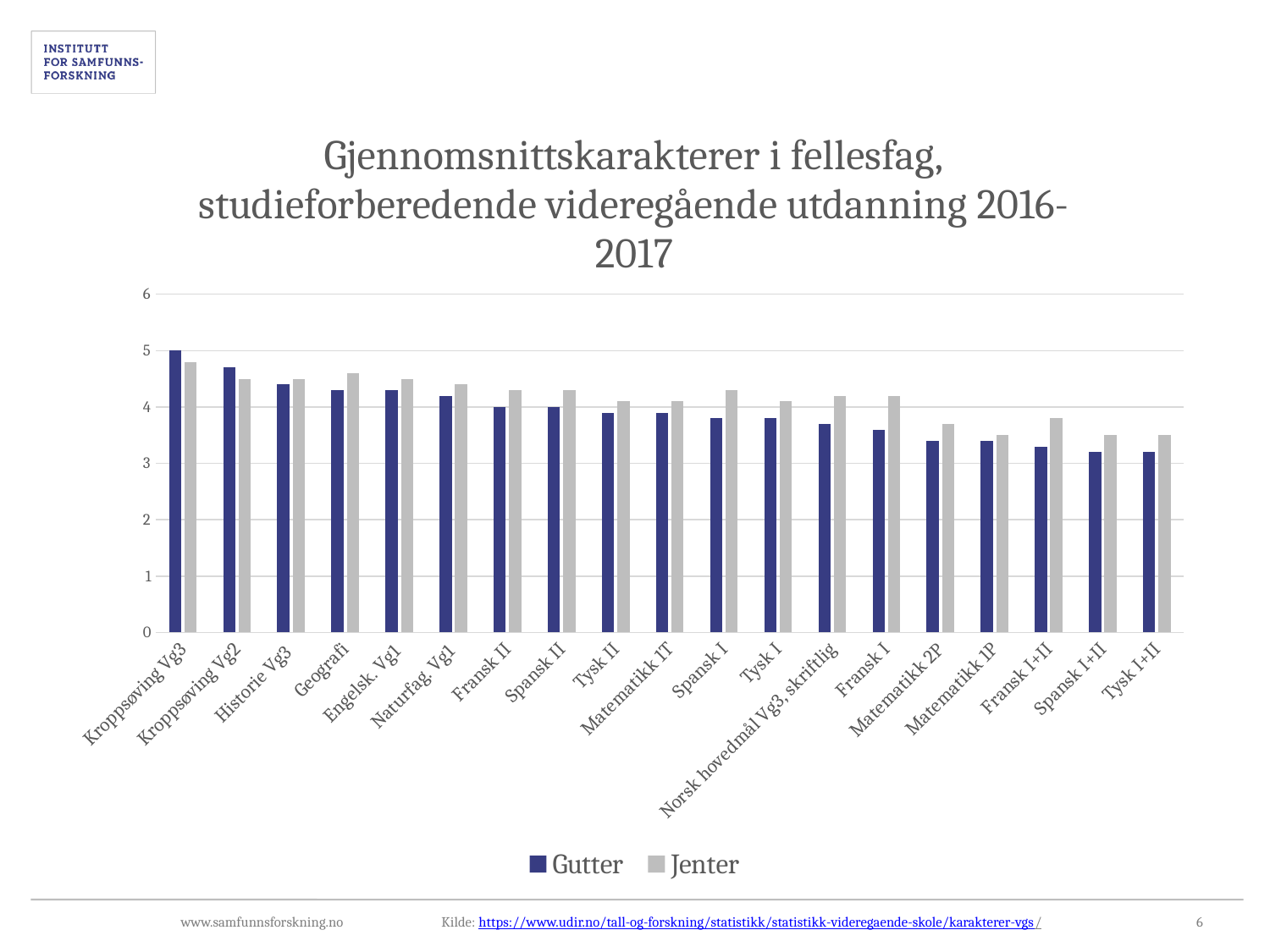
Which subject has the highest value for Gutter? Kroppsøving Vg3 How many subject categories are shown on the x axis? 19 Which subject has the highest value for Jenter? Kroppsøving Vg3 For Fransk I, which is larger, Gutter or Jenter? Jenter Is the Gutter value for Matematikk 2P greater or less than 4? less How many series does the legend list? 2 Is the Jenter value for Geografi greater or less than 4? greater Which colour represents the Jenter series in the legend? Grey For Kroppsøving Vg3, which is larger, Gutter or Jenter? Gutter Do the Gutter values generally rise or fall from left to right along the x axis? Fall What kind of chart is shown on the slide? Bar chart Is the Gutter value for Tysk I+II greater or less than 4? less